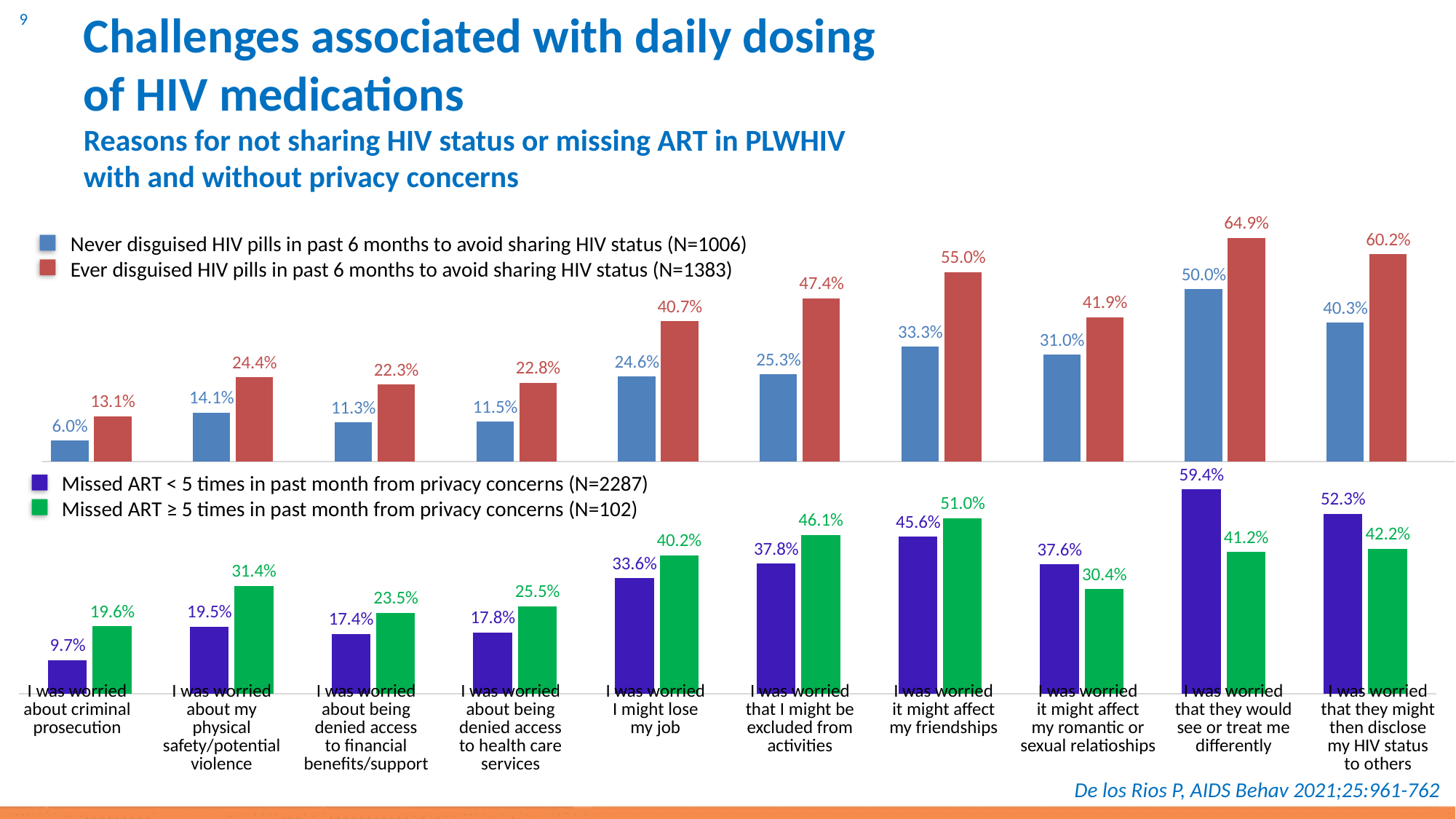
How many categories are shown on the x axis of the bottom chart? 10 How many series does the legend of the top chart list? 2 What type of chart is the bottom chart? Bar chart In the bottom chart, which category has the lowest value for the 'Missed ART ≥ 5 times' series? I was worried about criminal prosecution In the bottom chart, what is the difference between the 'Missed ART < 5 times' and 'Missed ART ≥ 5 times' values for 'I was worried that they might then disclose my HIV status to others'? 10.1% In the top chart, what is the difference between the 'Ever disguised' and 'Never disguised' values for 'I was worried that I might be excluded from activities'? 22.1% In the top chart, what is the value for 'I was worried about criminal prosecution' for the 'Never disguised HIV pills' series? 6.0% In the top chart, what colour are the bars for the 'Ever disguised HIV pills in past 6 months' series? Red In the top chart, what is the value for 'I was worried I might lose my job' for the 'Ever disguised HIV pills' series? 40.7% In the bottom chart, for 'I was worried it might affect my romantic or sexual relationships', which series has the larger value? Missed ART < 5 times in past month from privacy concerns In the top chart, which category has the highest value for the 'Ever disguised HIV pills' series? I was worried that they would see or treat me differently In the bottom chart, what is the value for 'I was worried that they would see or treat me differently' for the 'Missed ART < 5 times' series? 59.4%